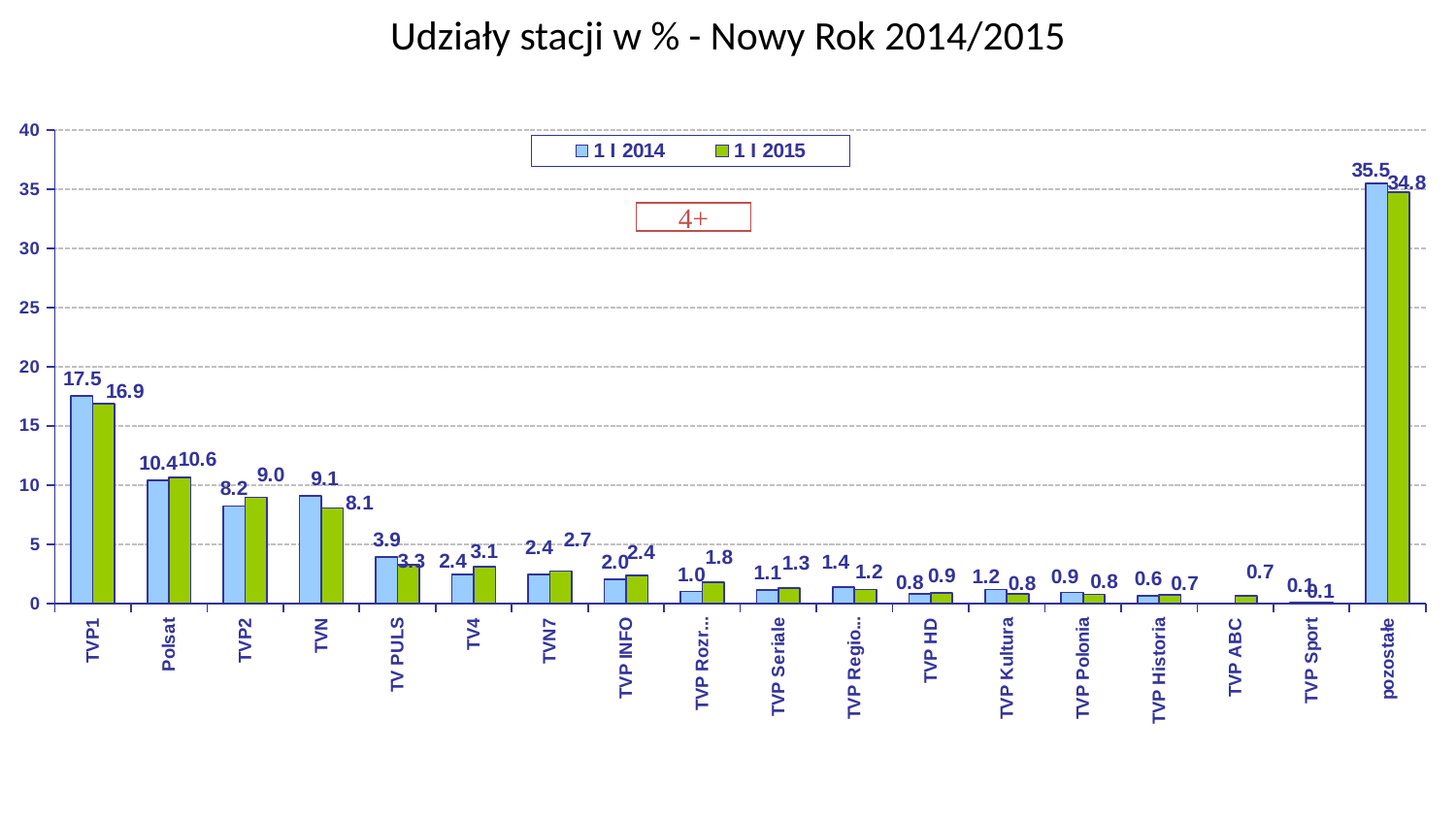
What is the value for TVN in the 1 I 2015 series? 8.1 How many series does the legend list? 2 What kind of chart is shown on the slide? bar chart Which is larger for TV PULS: the 1 I 2014 value or the 1 I 2015 value? 1 I 2014 What is the value for TVP ABC in the 1 I 2015 series? 0.7 What is the title of the chart? Udziały stacji w % - Nowy Rok 2014/2015 Which category has the lowest value in the 1 I 2015 series? TVP Sport What is the difference between the 1 I 2014 and 1 I 2015 values for TVP2? 0.8 What is the value for TVP1 in the 1 I 2014 series? 17.5 Is the 1 I 2015 value for pozostałe greater or less than 30? greater Which category has the highest value in the 1 I 2014 series? pozostałe What is the value for Polsat in the 1 I 2015 series? 10.6